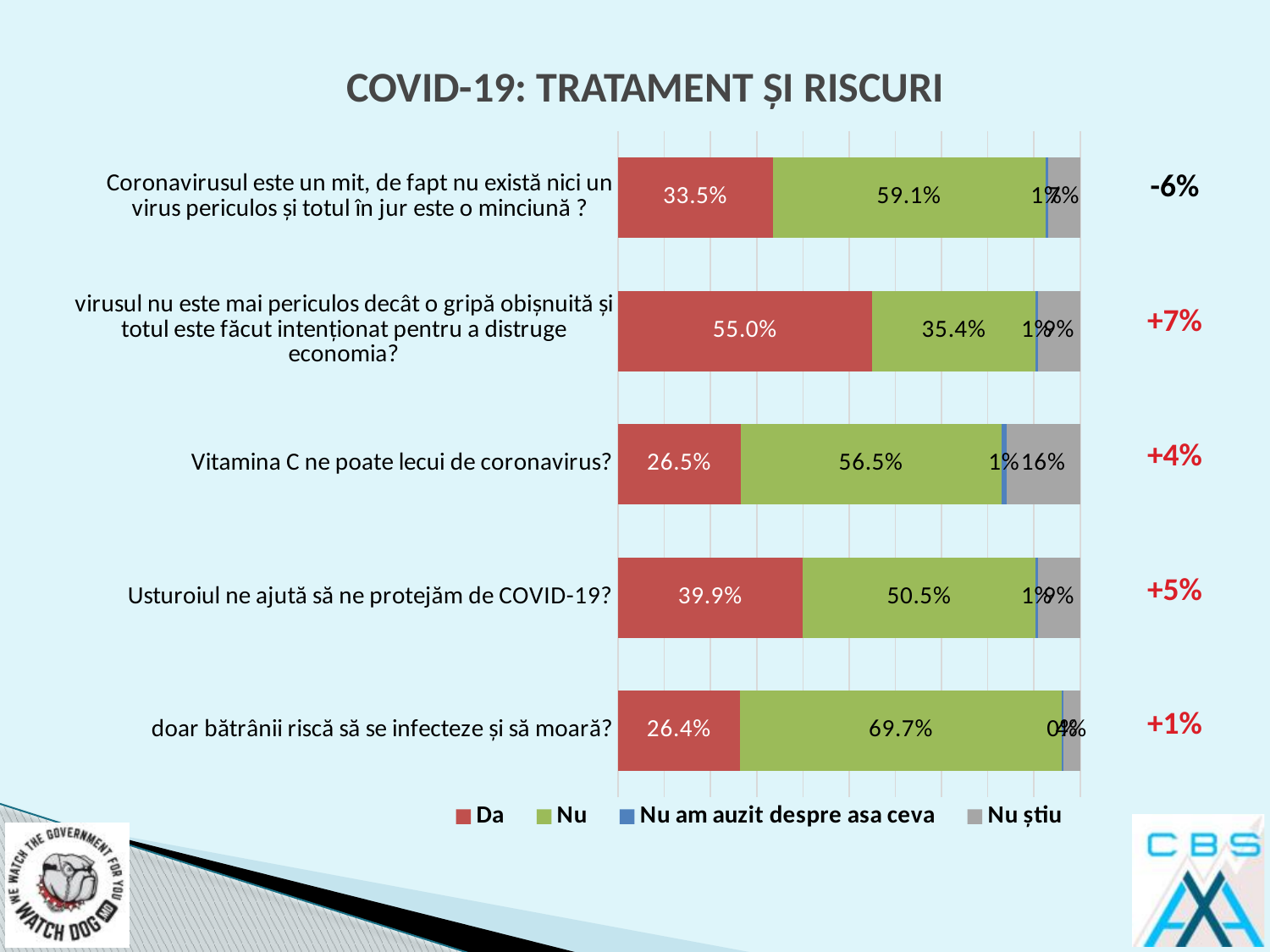
What is the 'Da' value for 'Vitamina C ne poate lecui de coronavirus?' 26.5% What is the 'Nu' value for 'Usturoiul ne ajută să ne protejăm de COVID-19?' 50.5% How many statements (categories) are plotted in the chart? 5 Which statement has the highest 'Da' value? virusul nu este mai periculos decât o gripă obișnuită și totul este făcut intenționat pentru a distruge economia? Which is larger: the 'Da' value for 'Usturoiul ne ajută să ne protejăm de COVID-19?' or the 'Da' value for 'Coronavirusul este un mit...'? Usturoiul ne ajută să ne protejăm de COVID-19? How many series does the legend list? 4 For 'Coronavirusul este un mit...', how much larger is the 'Nu' value than the 'Da' value? 25.6 percentage points What is the 'Nu' value for 'virusul nu este mai periculos decât o gripă obișnuită și totul este făcut intenționat pentru a distruge economia?' 35.4% What kind of chart is shown on the slide? Stacked bar chart What is the 'Da' value for 'Coronavirusul este un mit, de fapt nu există nici un virus periculos și totul în jur este o minciună?' 33.5% Which statement has the highest 'Nu' value? doar bătrânii riscă să se infecteze și să moară? Which statement has the lowest 'Nu' value? virusul nu este mai periculos decât o gripă obișnuită și totul este făcut intenționat pentru a distruge economia?